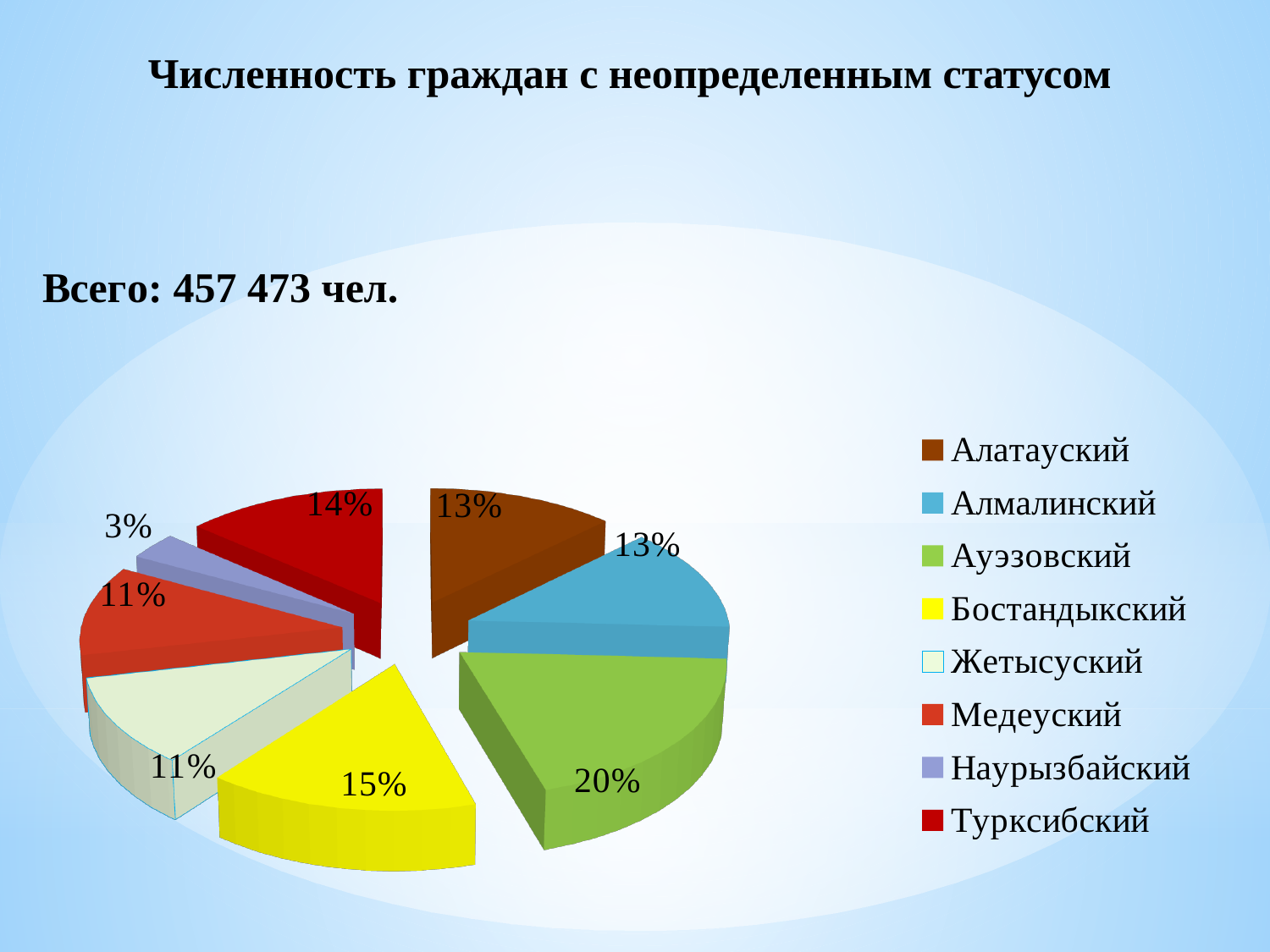
What share of the pie does Алатауский have? 13% What share of the pie does Турксибский have? 14% What is the difference in percentage points between the shares of Ауэзовский and Бостандыкский? 5 Which has the larger share, Турксибский or Бостандыкский? Бостандыкский Which district has the largest share of the pie? Ауэзовский What share of the pie does Ауэзовский have? 20% Which district has the smallest share of the pie? Наурызбайский What total number of people is stated on the slide? 457 473 чел. What kind of chart is shown on the slide? pie chart How many districts are listed in the legend? 8